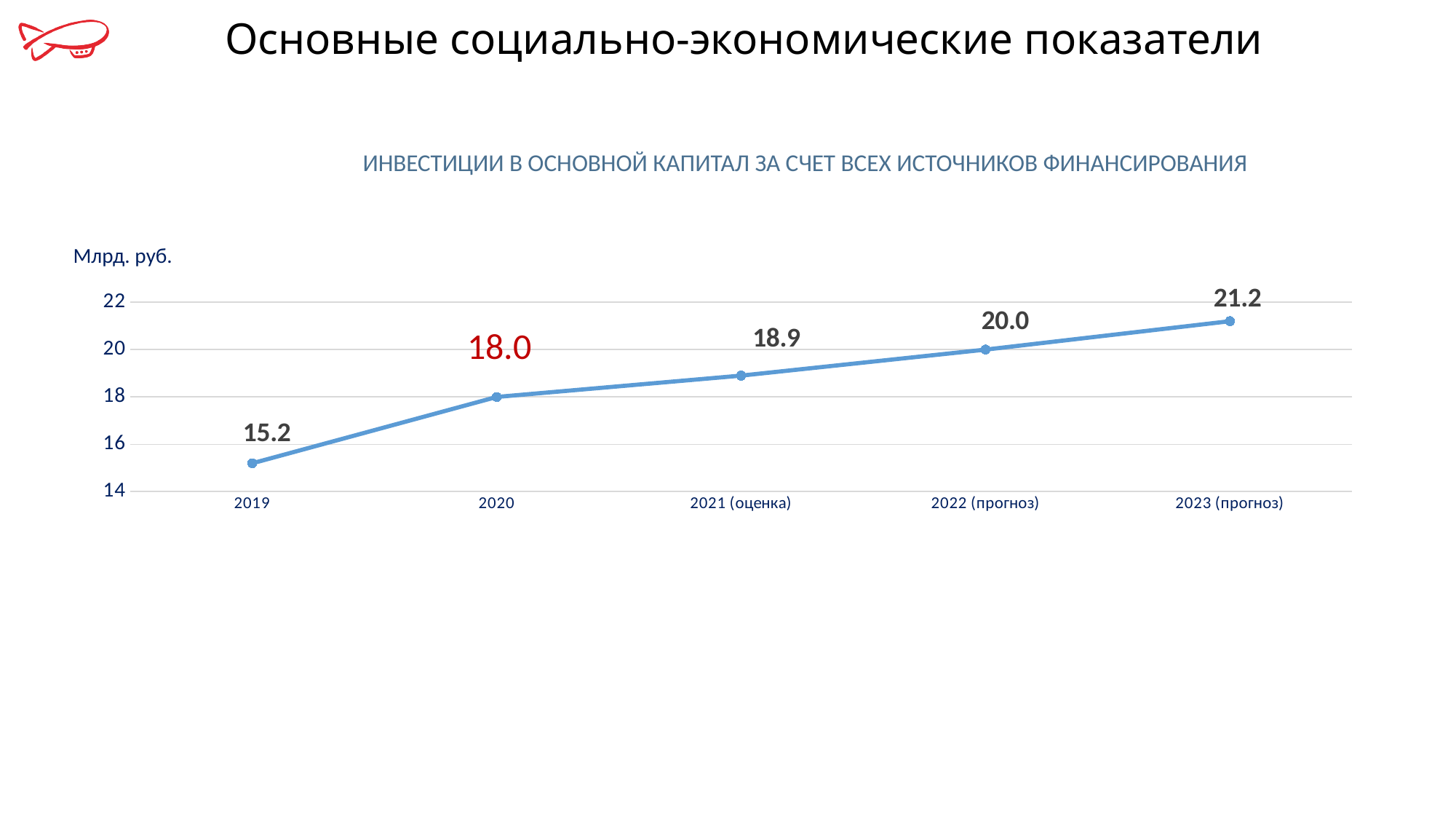
What kind of chart is shown on the slide? line chart Which is larger, the value for 2020 or the value for 2022 (прогноз)? 2022 (прогноз) How many data points are plotted on the chart? 5 What is the value for 2020? 18.0 Which year has the lowest value? 2019 What is the difference between the values for 2023 (прогноз) and 2019? 6.0 What is the value for 2021 (оценка)? 18.9 Which year has the highest value? 2023 (прогноз) Do the values rise or fall from 2019 to 2023 (прогноз)? rise What is the value for 2019? 15.2 What unit is shown on the vertical axis of the chart? Млрд. руб. What is the value for 2023 (прогноз)? 21.2